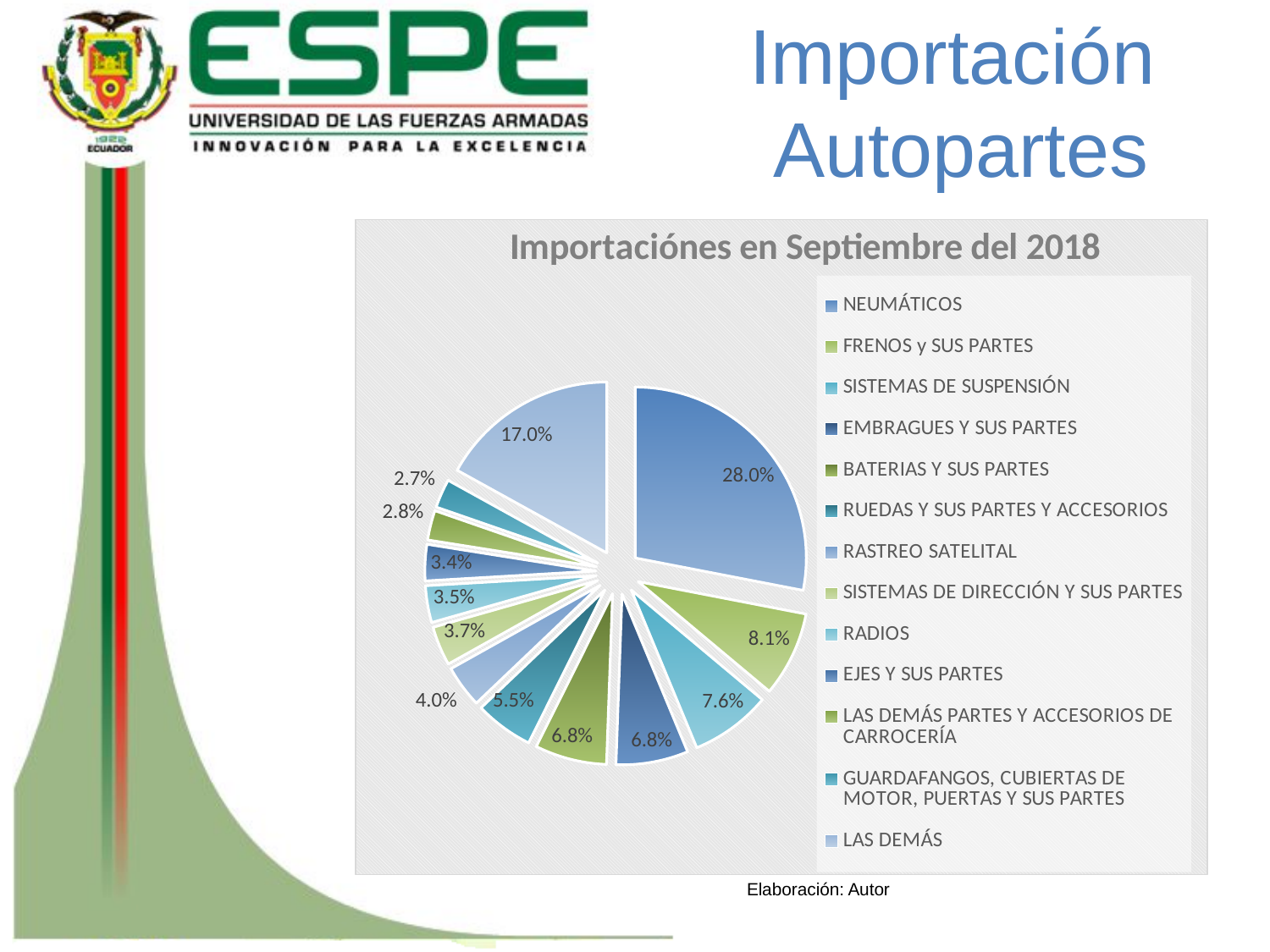
What is the smallest percentage value labelled on the pie chart? 2.7% Is the share for NEUMÁTICOS greater or less than 25%? greater What percentage is shown for FRENOS y SUS PARTES? 8.1% What share of the pie does NEUMÁTICOS represent? 28.0% What type of chart is shown on the slide? Pie chart What share of the pie does LAS DEMÁS represent? 17.0% Which category has the largest slice of the pie? NEUMÁTICOS How many categories does the legend of the pie chart list? 13 What is the title of the chart? Importaciónes en Septiembre del 2018 Which is larger, the slice for FRENOS y SUS PARTES or the slice for SISTEMAS DE SUSPENSIÓN? FRENOS y SUS PARTES What percentage is shown for SISTEMAS DE SUSPENSIÓN? 7.6% What is the difference in percentage points between the NEUMÁTICOS slice (28.0%) and the LAS DEMÁS slice (17.0%)? 11.0 percentage points